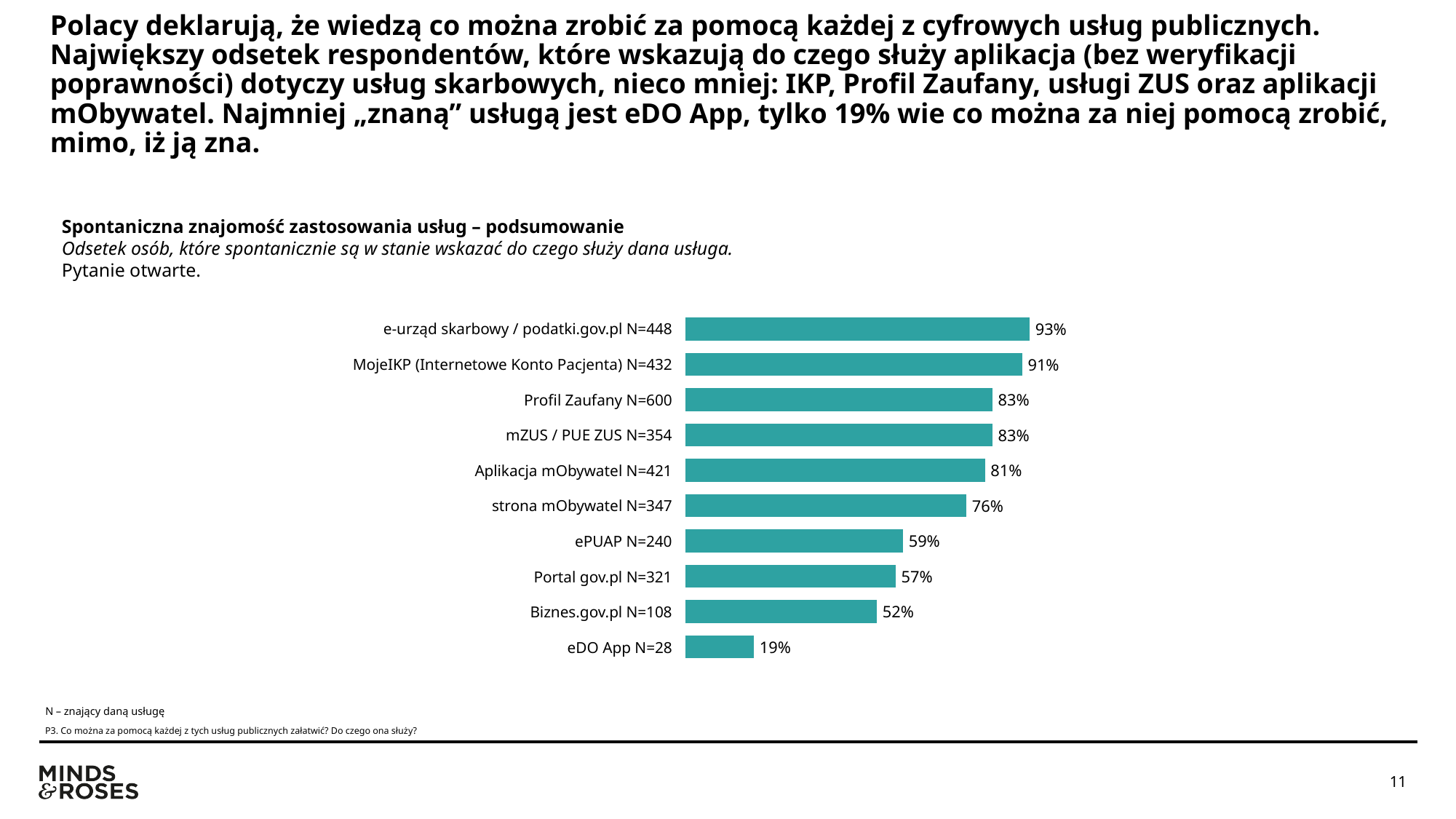
What kind of chart is shown on the slide? Bar chart What is the difference between the values for MojeIKP (Internetowe Konto Pacjenta) and ePUAP? 32% What is the value for strona mObywatel? 76% What is the difference between the values for Aplikacja mObywatel and Portal gov.pl? 24% What is the N (number of respondents) shown for Profil Zaufany? 600 What is the value for e-urząd skarbowy / podatki.gov.pl? 93% What is the value for eDO App? 19% How many categories are shown in the chart? 10 Which category has the highest value? e-urząd skarbowy / podatki.gov.pl Which category has the lowest value? eDO App Which is larger, the value for ePUAP or the value for Biznes.gov.pl? ePUAP What is the value for Biznes.gov.pl? 52%